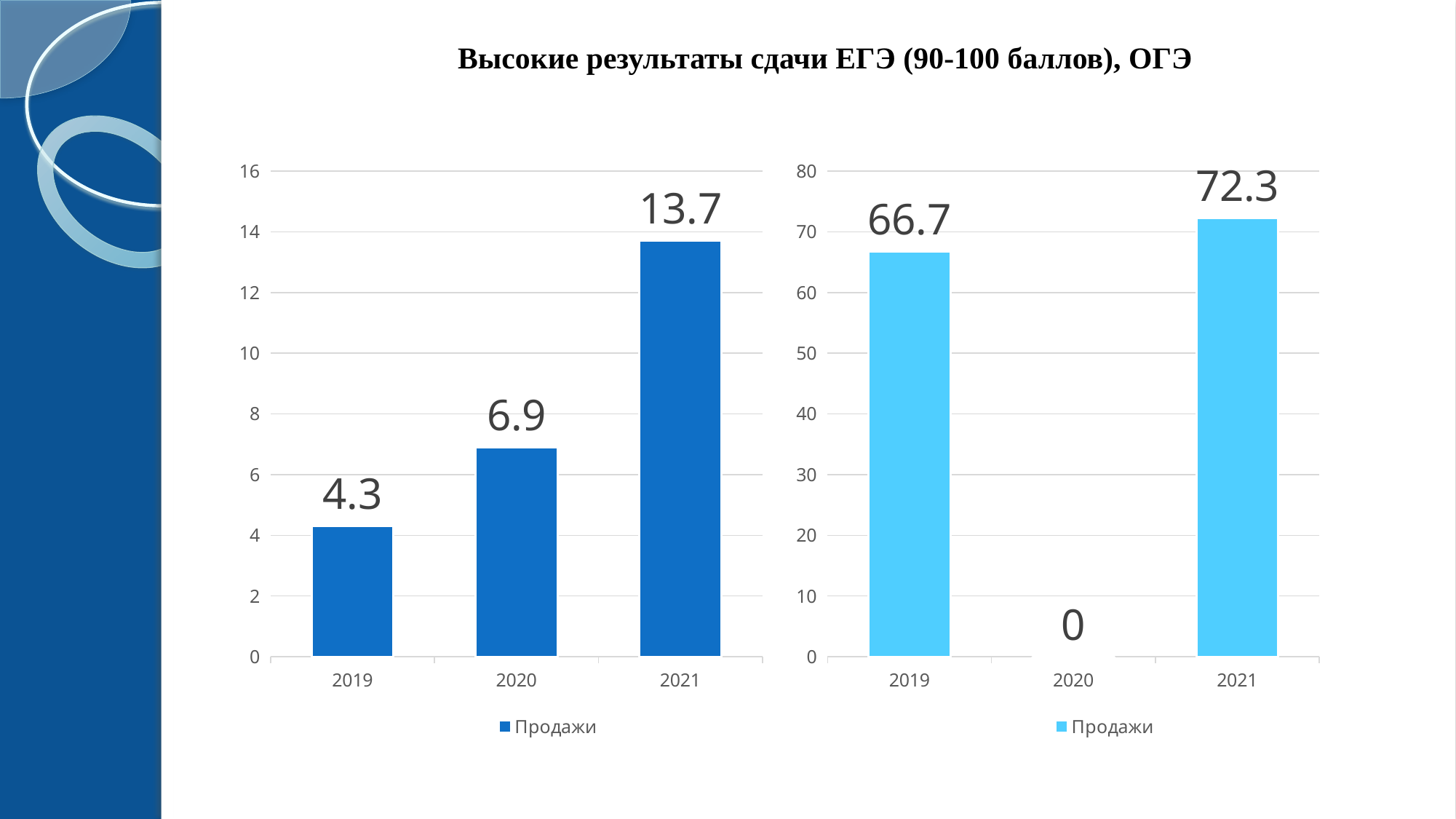
In the right chart, which year has the highest value? 2021 In the right chart, what is the difference between the values for 2021 and 2019? 5.6 In the right chart, what is the value for 2019? 66.7 In the right chart, what is the value for 2020? 0 In the left chart, what is the value for 2021? 13.7 How many years are shown on the x axis of the right chart? 3 In the left chart, is the value for 2021 greater or less than 12? greater In the left chart, what is the difference between the values for 2021 and 2020? 6.8 What type of chart is the left chart? bar chart In the left chart, which year has the lowest value? 2019 In the left chart, which is larger: the value for 2020 or the value for 2019? 2020 What is the legend entry shown under the right chart? Продажи